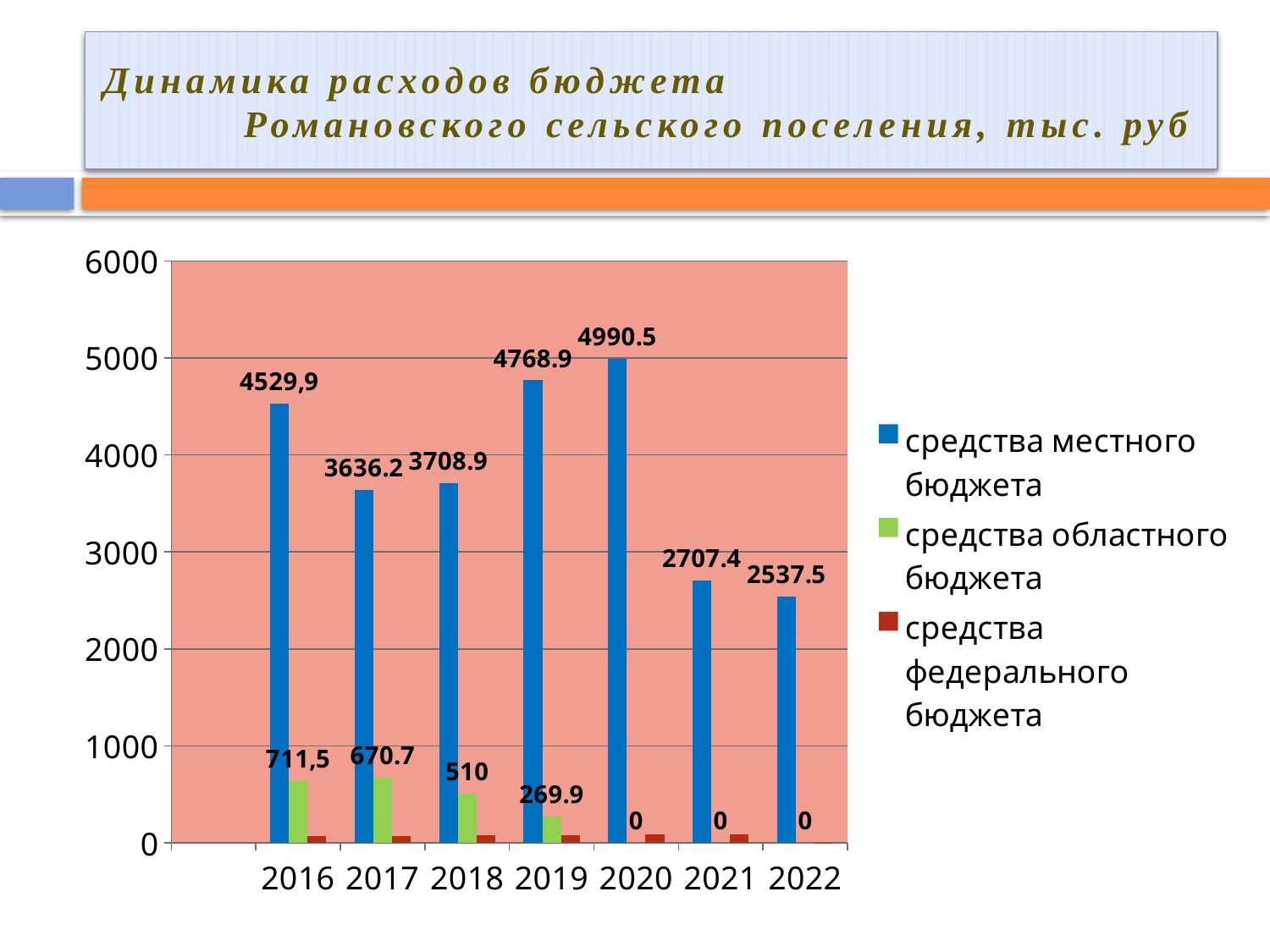
What is the value of средства областного бюджета for 2021? 0 How many years are shown on the x axis? 7 What is the value of средства местного бюджета for 2016? 4529,9 What is the difference between средства местного бюджета in 2020 and in 2021? 2283.1 In which year is средства местного бюджета lowest? 2022 Is the value of средства федерального бюджета for 2019 greater or less than 1000? less What kind of chart is shown on the slide? bar chart What is the value of средства местного бюджета for 2020? 4990.5 Which is larger, средства местного бюджета in 2017 or in 2018? 2018 What is the value of средства областного бюджета for 2018? 510 In which year is средства местного бюджета highest? 2020 How many series does the legend list? 3